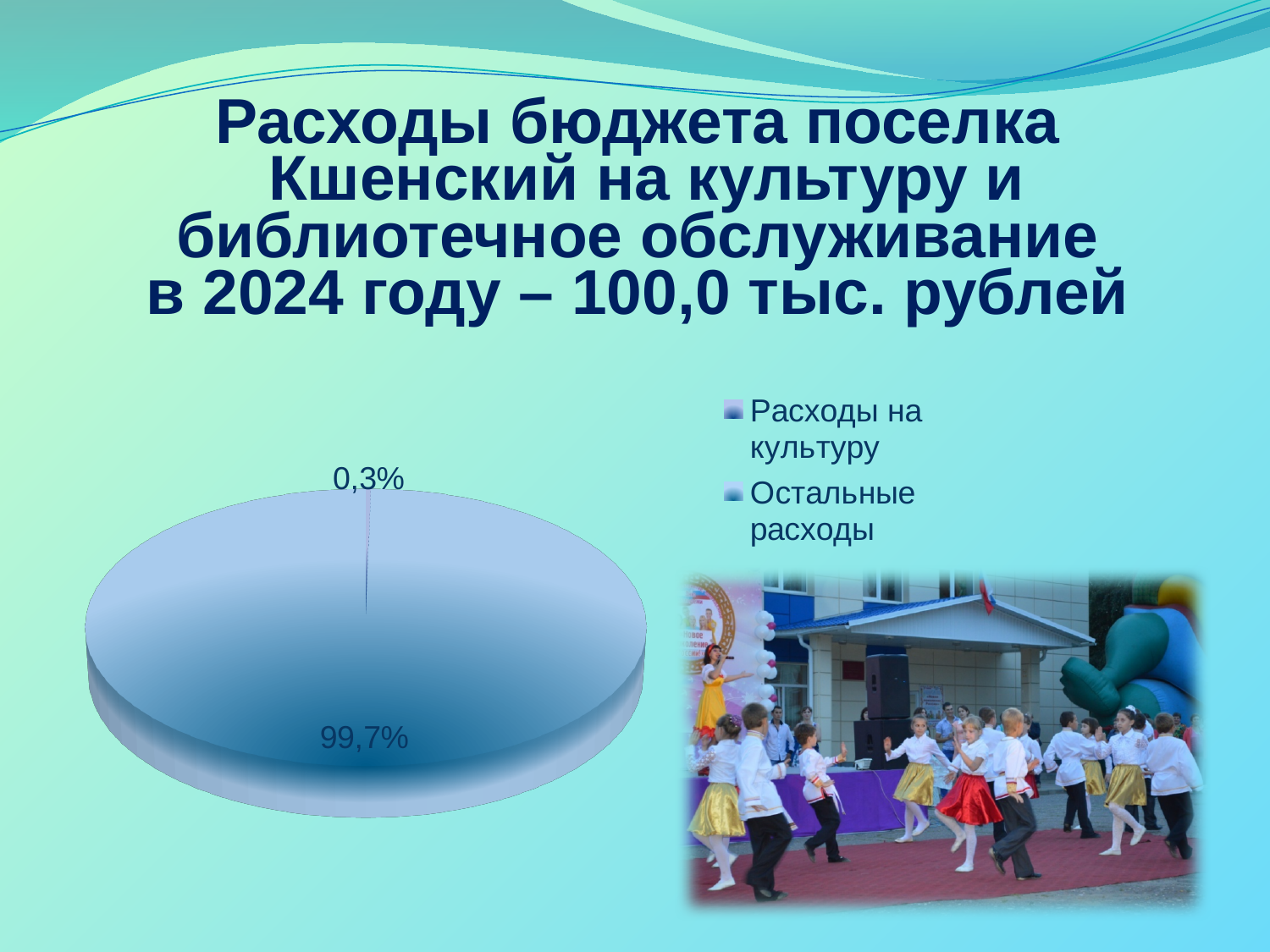
According to the slide title, what is the amount of budget expenditure on culture and library services in 2024? 100,0 тыс. рублей What is the difference in percentage points between the "Остальные расходы" slice and the "Расходы на культуру" slice? 99,4 Which category has the largest slice of the pie? Остальные расходы What is the first entry listed in the legend of the pie chart? Расходы на культуру Which is larger: the slice for "Расходы на культуру" or the slice for "Остальные расходы"? Остальные расходы What share of the pie is labelled for "Расходы на культуру"? 0,3% What share of the pie is labelled for "Остальные расходы"? 99,7% What kind of chart is shown on the slide? pie chart How many slices does the pie chart have? 2 How many entries does the legend of the pie chart list? 2 Which category has the smallest slice of the pie? Расходы на культуру